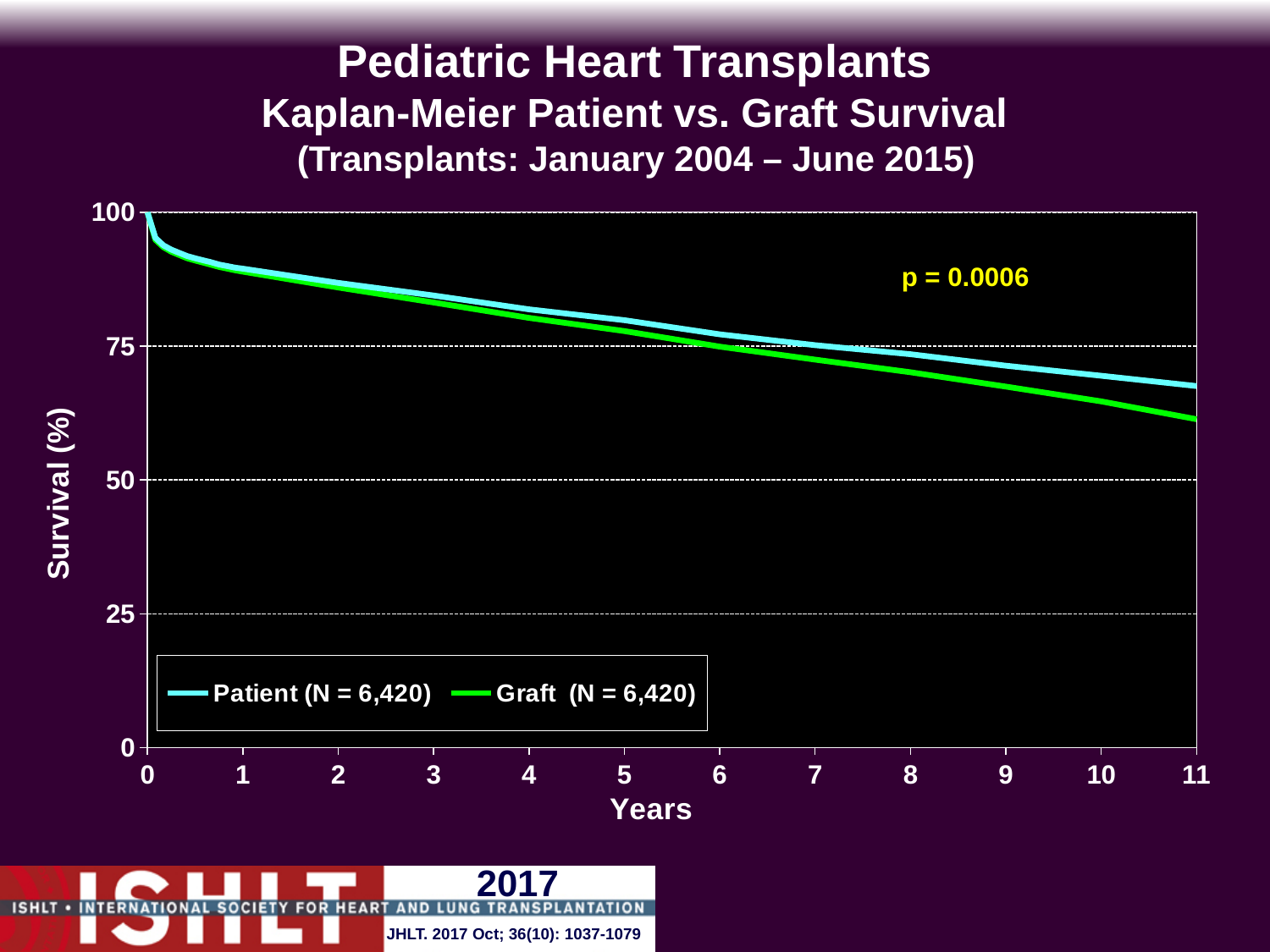
What kind of chart is shown on the slide? Line chart Is the Patient survival at 1 year greater or less than 75? greater Is the Patient survival at 10 years greater or less than 75? less Is the Patient survival at 11 years greater or less than 50? greater What is the N for the Graft series in the legend? 6,420 How many series does the legend list? 2 At 11 years, which series has the higher survival, Patient or Graft? Patient What is the p-value shown on the chart? p = 0.0006 What is the label of the y axis? Survival (%) Do the survival curves rise or fall as the years increase? Fall